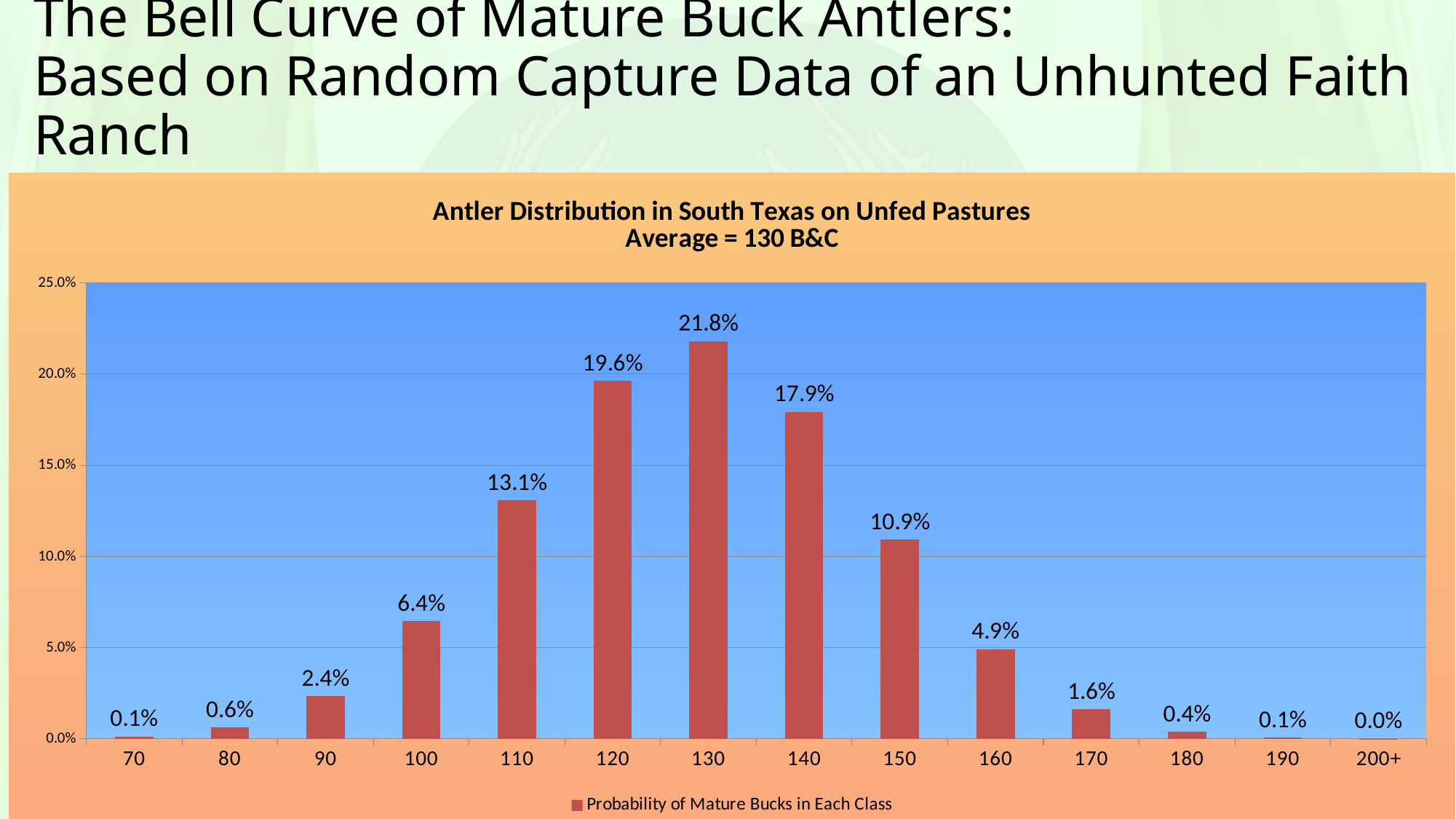
Which antler class has the highest probability? 130 Is the value for the 140 class greater or less than 15.0%? greater What is the probability of mature bucks in the 100 class? 6.4% What is the probability of mature bucks in the 160 class? 4.9% How many series does the legend list? 1 What is the difference between the probability for the 120 class and the 140 class? 1.7% What is the title of the chart? Antler Distribution in South Texas on Unfed Pastures Average = 130 B&C Which antler class has the lowest probability? 200+ How many antler classes are shown on the x axis? 14 What is the probability of mature bucks in the 130 class? 21.8% Which has a higher probability, the 110 class or the 150 class? 110 What kind of chart is shown? bar chart